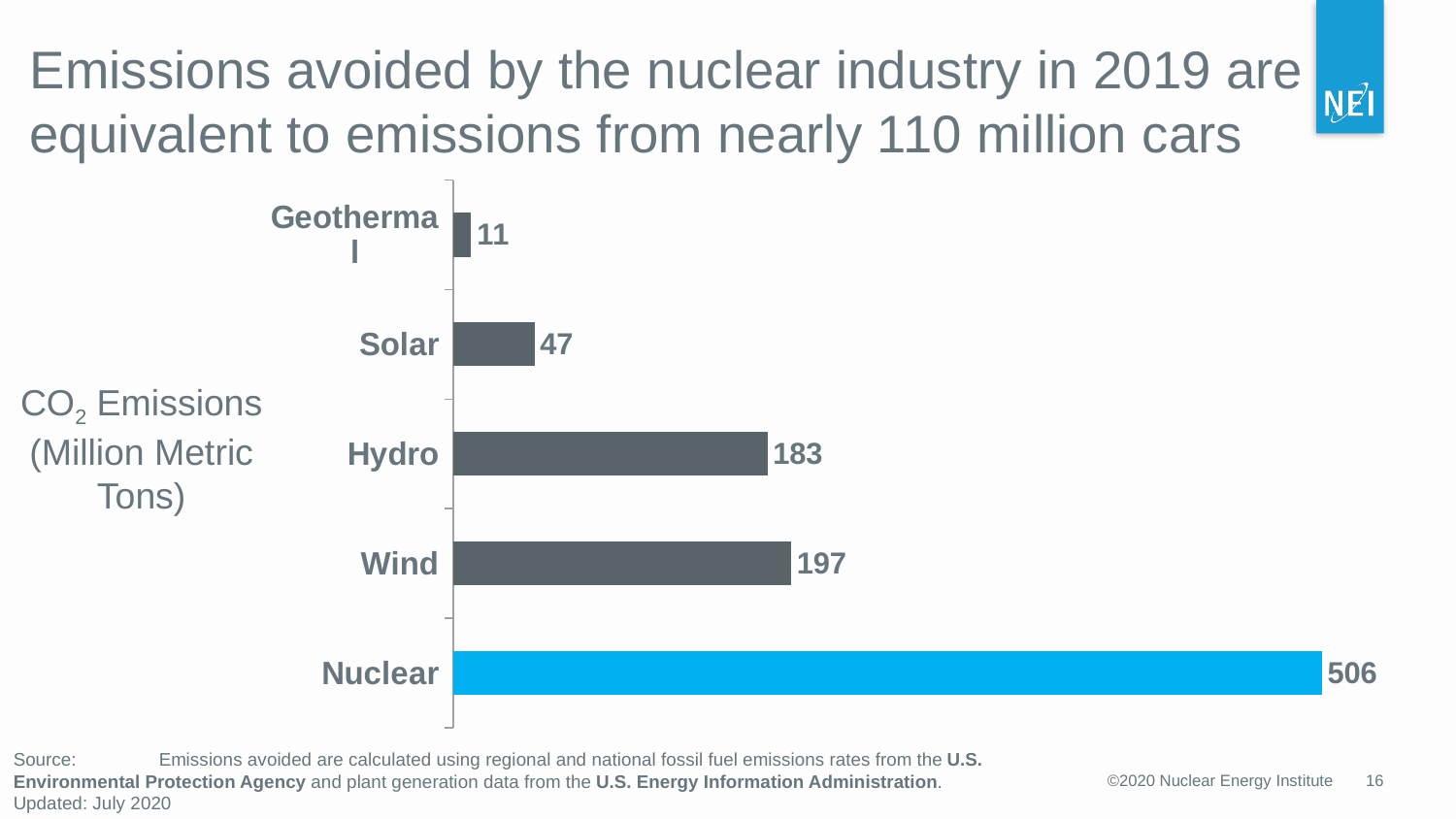
What kind of chart is shown on the slide? Bar chart Which is larger, the value for Hydro or the value for Solar? Hydro What is the difference between the values for Nuclear and Wind? 309 Which category has the lowest value? Geothermal What is the value for Nuclear? 506 How many categories are shown in the chart? 5 What is the difference between the values for Solar and Geothermal? 36 What is the value for Wind? 197 Which category has the highest value? Nuclear What is the value for Solar? 47 What is the value for Hydro? 183 What is the value for Geothermal? 11